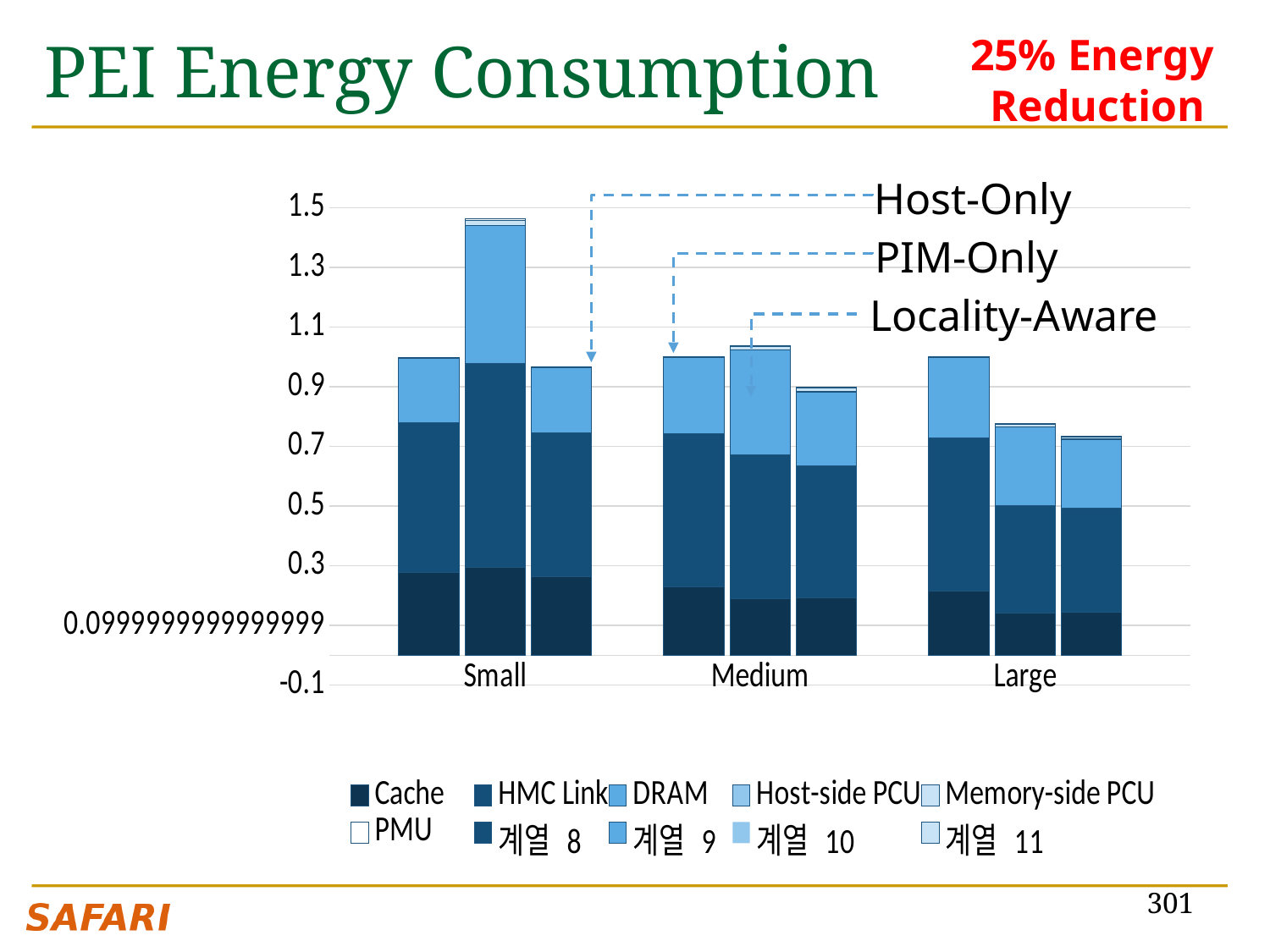
Which category has the shortest Locality-Aware bar? Large Is the total of the PIM-Only bar for Small greater or less than 1.3? greater Is the total of the Locality-Aware bar for Large greater or less than 0.9? less Which is taller, the PIM-Only bar for Small or the PIM-Only bar for Medium? PIM-Only bar for Small What kind of chart is shown on the slide? stacked bar chart Which category has the tallest PIM-Only bar? Small What is the title of the chart on the slide? PEI Energy Consumption How many categories are shown on the x axis of the chart? 3 Is the total of the PIM-Only bar for Large greater or less than 0.9? less Which three bar configurations are labelled by the dashed arrows in the chart? Host-Only, PIM-Only, Locality-Aware How many series does the chart's legend list? 10